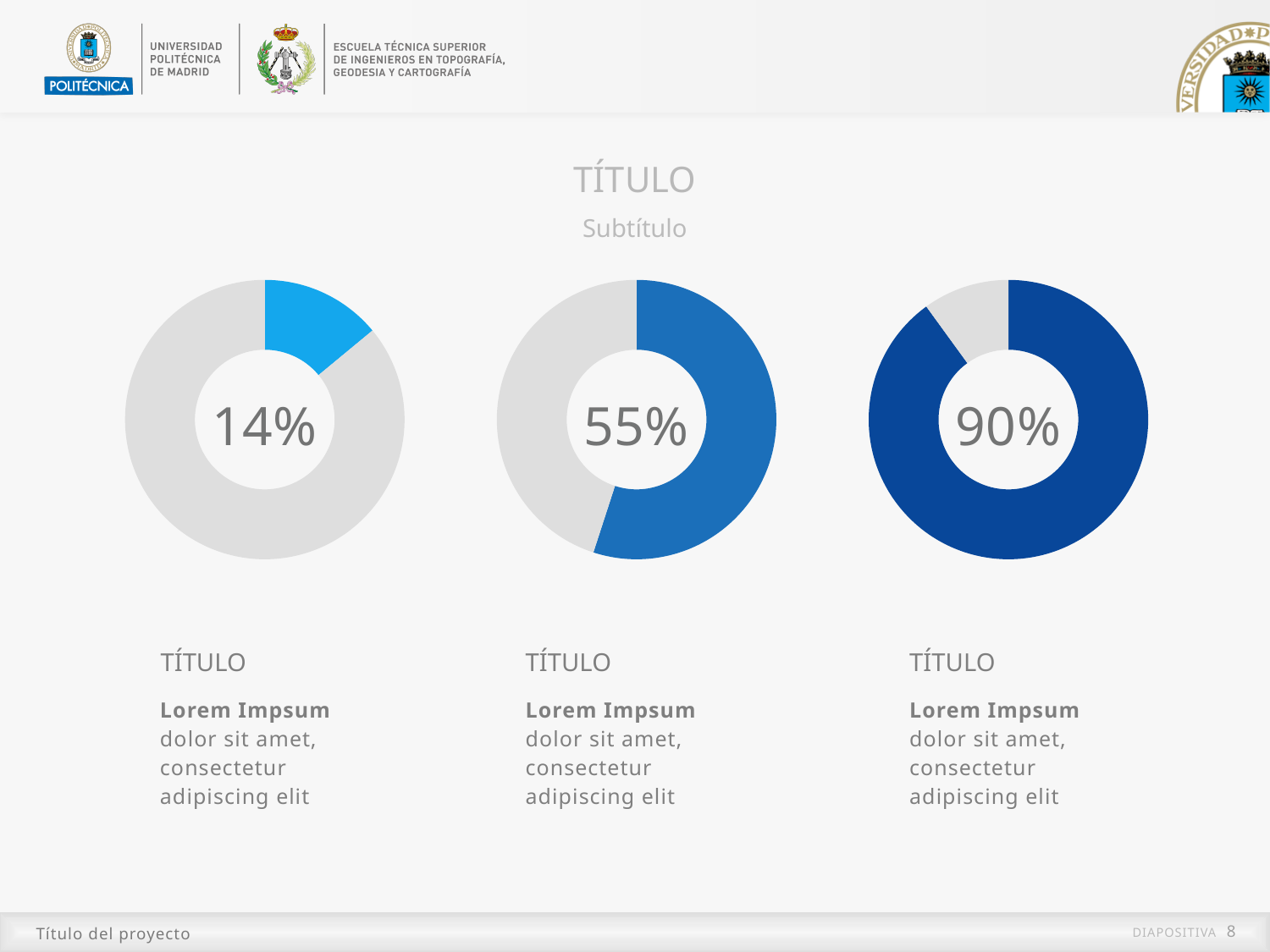
What value is shown in the centre of the left donut chart? 14% Which is larger, the percentage in the middle donut chart or the percentage in the left donut chart? Middle donut chart What colour is the filled segment of the left donut chart? Light blue What kind of chart is used for the three figures on the slide? Donut chart What is the difference between the percentage in the right donut chart and the percentage in the left donut chart? 76% How many donut charts are on the slide? 3 What value is shown in the centre of the right donut chart? 90% What is the difference between the percentage in the middle donut chart and the percentage in the left donut chart? 41% In the right donut chart, what share of the ring is filled with the dark blue colour? 90% Which donut chart shows the highest percentage: left, middle or right? Right What value is shown in the centre of the middle donut chart? 55% Which donut chart shows the lowest percentage: left, middle or right? Left